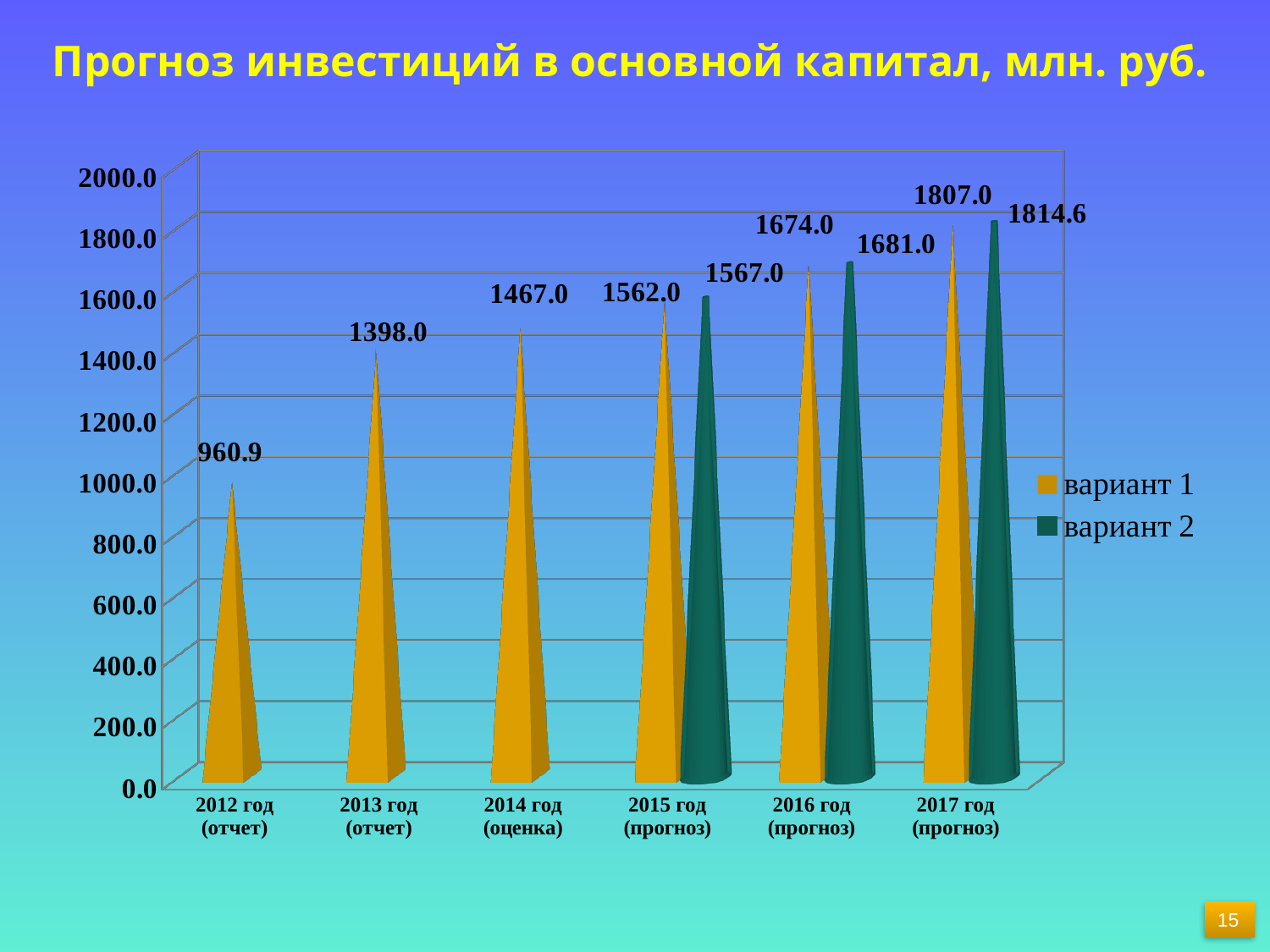
What is the value for вариант 2 in 2017 год (прогноз)? 1814.6 What is the value for вариант 2 in 2015 год (прогноз)? 1567.0 Which year has the highest value for вариант 2? 2017 год (прогноз) Do the values for вариант 1 rise or fall from 2012 to 2017? rise What kind of chart is shown on the slide? bar chart How many year categories are shown on the x axis? 6 What is the value for вариант 1 in 2012 год (отчет)? 960.9 What is the difference between вариант 2 and вариант 1 in 2016 год (прогноз)? 7.0 Which is larger in 2017 год (прогноз): вариант 1 or вариант 2? вариант 2 Which year has the lowest value for вариант 1? 2012 год (отчет) What is the value for вариант 1 in 2014 год (оценка)? 1467.0 How many series does the legend list? 2